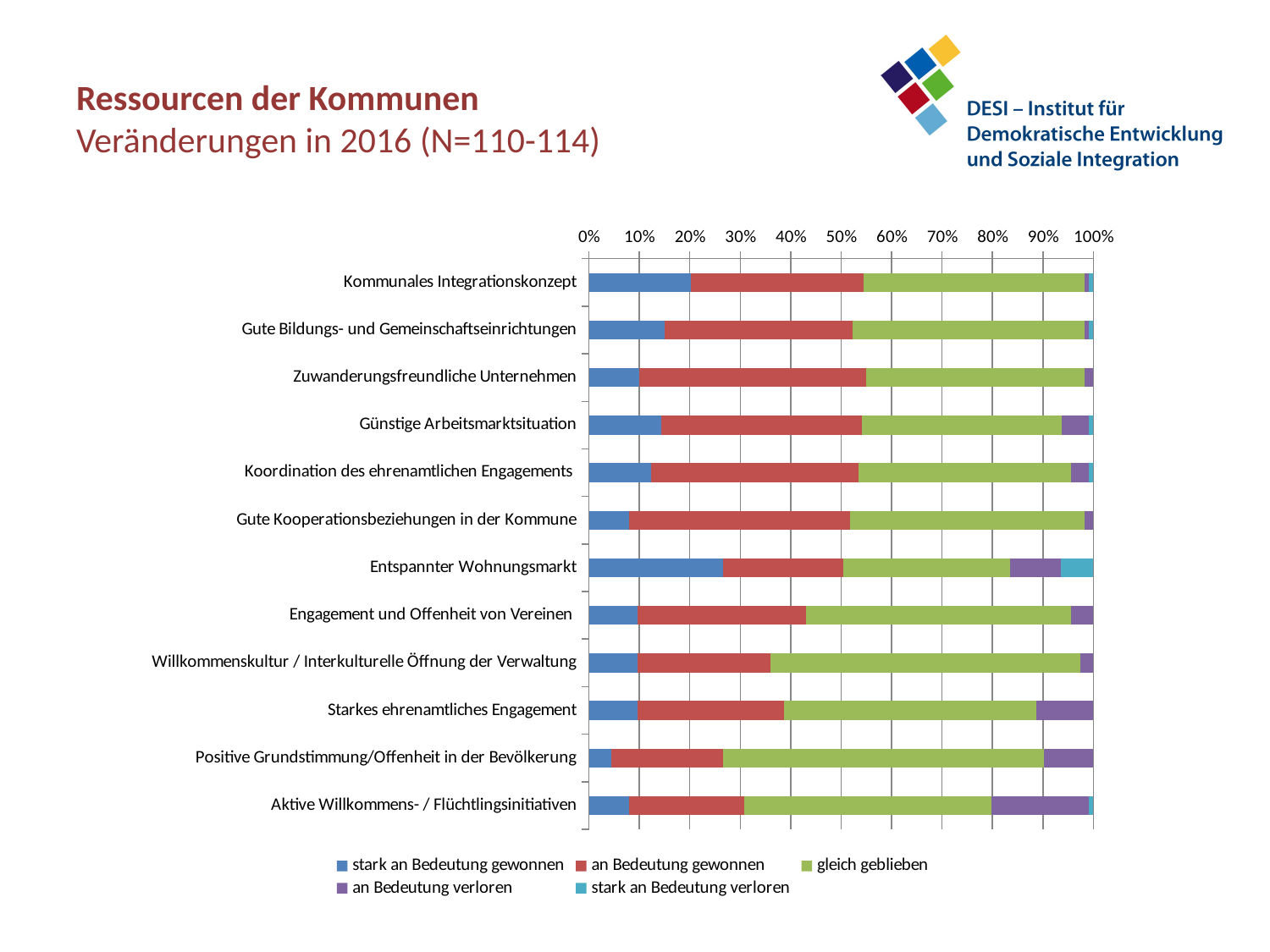
Which category has the largest 'an Bedeutung verloren' segment? Aktive Willkommens- / Flüchtlingsinitiativen How many series does the chart legend list? 5 Is the 'stark an Bedeutung gewonnen' value for Entspannter Wohnungsmarkt greater or less than 20%? greater Which series is shown in green in the chart legend? gleich geblieben Which has the larger 'stark an Bedeutung gewonnen' segment: Kommunales Integrationskonzept or Zuwanderungsfreundliche Unternehmen? Kommunales Integrationskonzept Which category has the largest 'stark an Bedeutung verloren' segment? Entspannter Wohnungsmarkt Which category has the smallest 'stark an Bedeutung gewonnen' segment? Positive Grundstimmung/Offenheit in der Bevölkerung Is the 'stark an Bedeutung gewonnen' value for Positive Grundstimmung/Offenheit in der Bevölkerung greater or less than 10%? less Which category has the largest 'stark an Bedeutung gewonnen' segment? Entspannter Wohnungsmarkt What is the title of the slide containing the chart? Ressourcen der Kommunen – Veränderungen in 2016 (N=110-114) How many categories (resources) are listed on the vertical axis of the chart? 12 What kind of chart is shown on the slide? Stacked bar chart